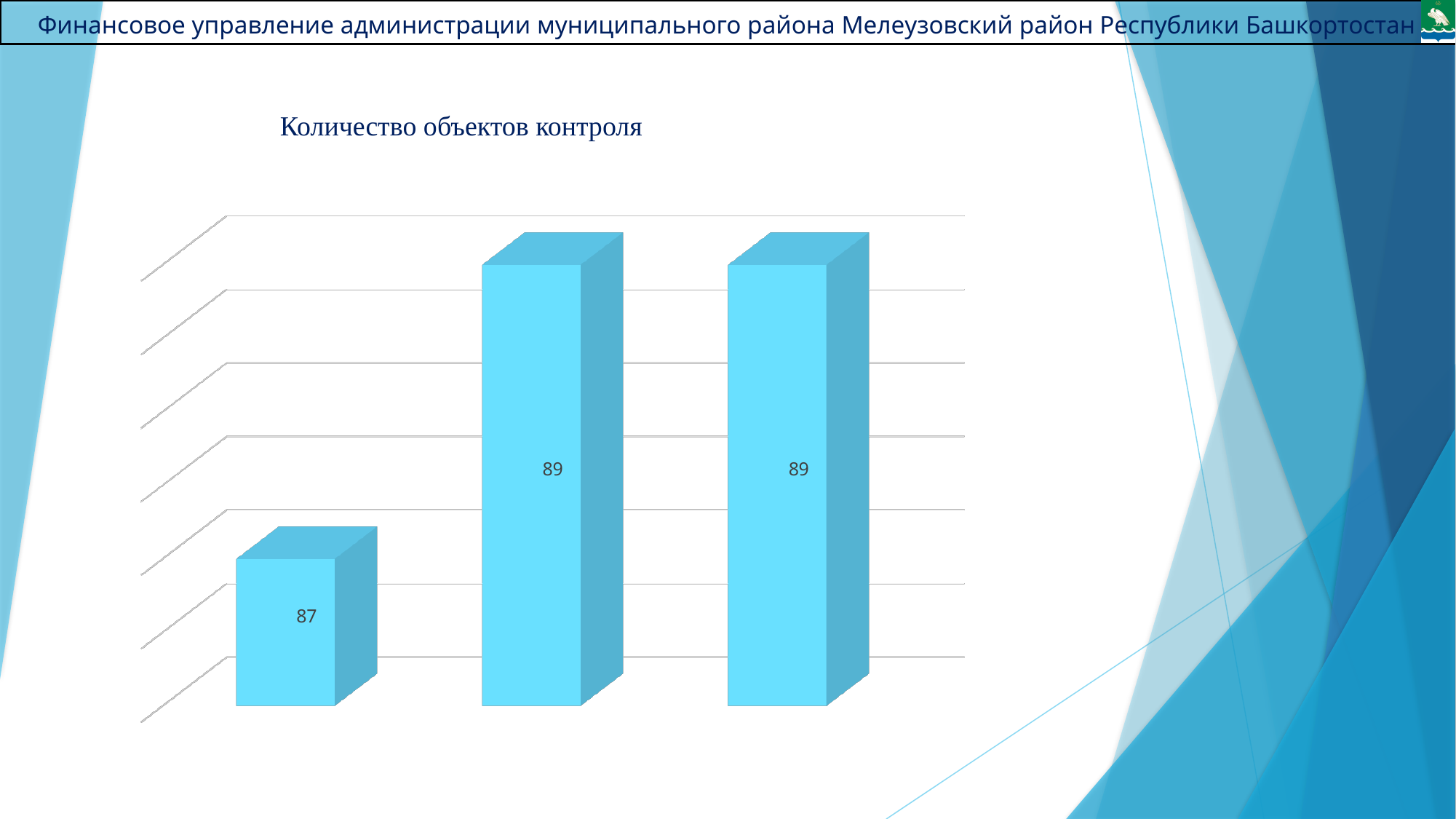
What kind of chart is shown on the slide? bar chart What is the value shown on the rightmost bar of the chart? 89 How many bars are plotted in the chart? 3 What is the value shown on the leftmost bar of the chart? 87 What is the title of the chart? Количество объектов контроля What colour are the bars in the chart? light blue Which bar has the lowest value in the chart? the leftmost bar Are the values of the middle bar and the rightmost bar equal? yes What is the value shown on the middle bar of the chart? 89 Does the value rise or fall from the leftmost bar to the middle bar? rise What is the difference between the value of the middle bar and the value of the leftmost bar? 2 Which is larger, the value of the leftmost bar or the value of the rightmost bar? the rightmost bar